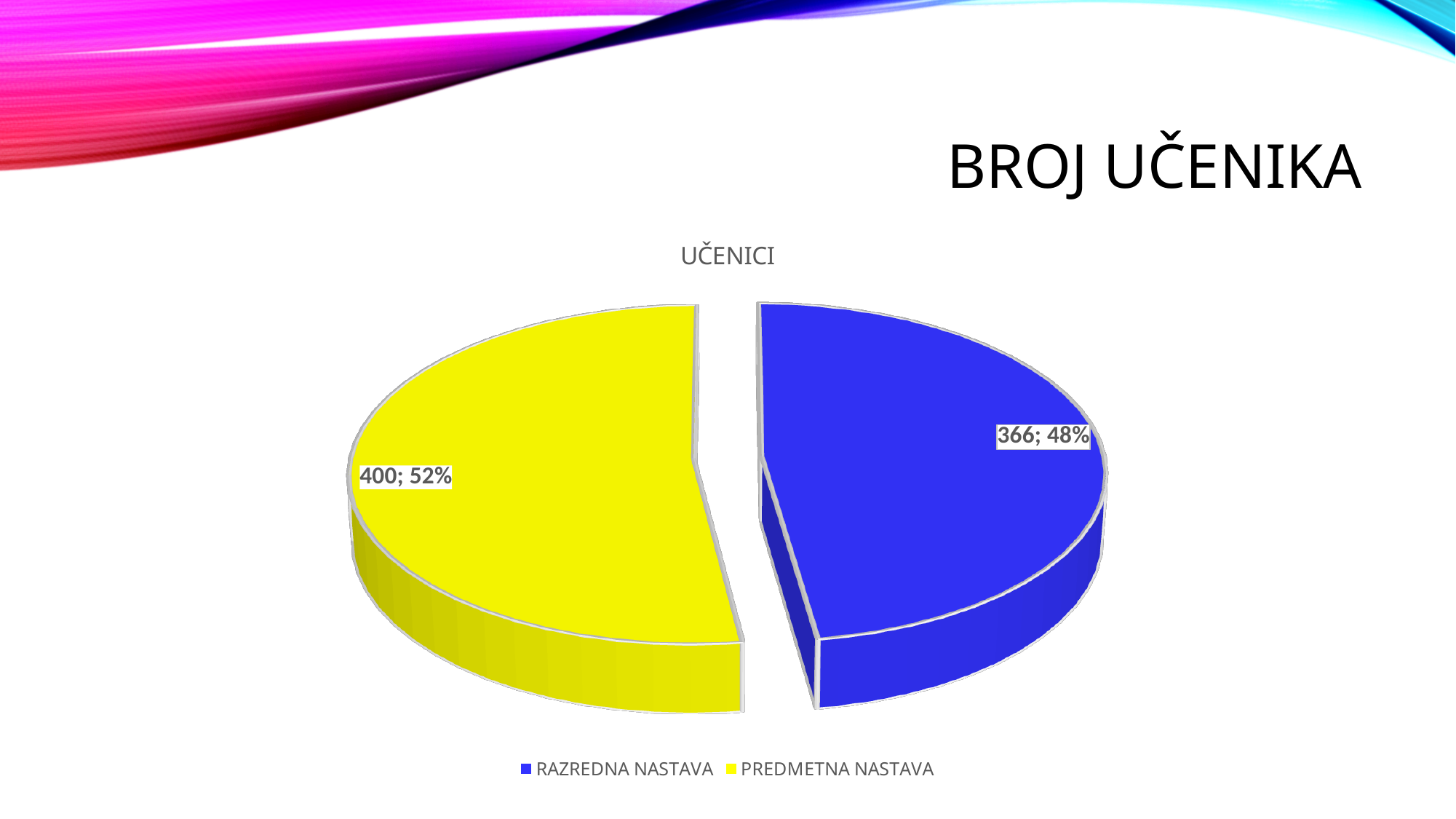
Which category has the largest slice? PREDMETNA NASTAVA What is the difference between the values for PREDMETNA NASTAVA and RAZREDNA NASTAVA? 34 Which category has the smallest slice? RAZREDNA NASTAVA Which colour represents RAZREDNA NASTAVA in the chart? blue What kind of chart is shown on the slide? pie chart What share of the pie does PREDMETNA NASTAVA represent? 52% How many slices does the pie chart have? 2 What is the value for PREDMETNA NASTAVA? 400 What share of the pie does RAZREDNA NASTAVA represent? 48% How many entries does the legend list? 2 What is the value for RAZREDNA NASTAVA? 366 What is the chart's title? UČENICI